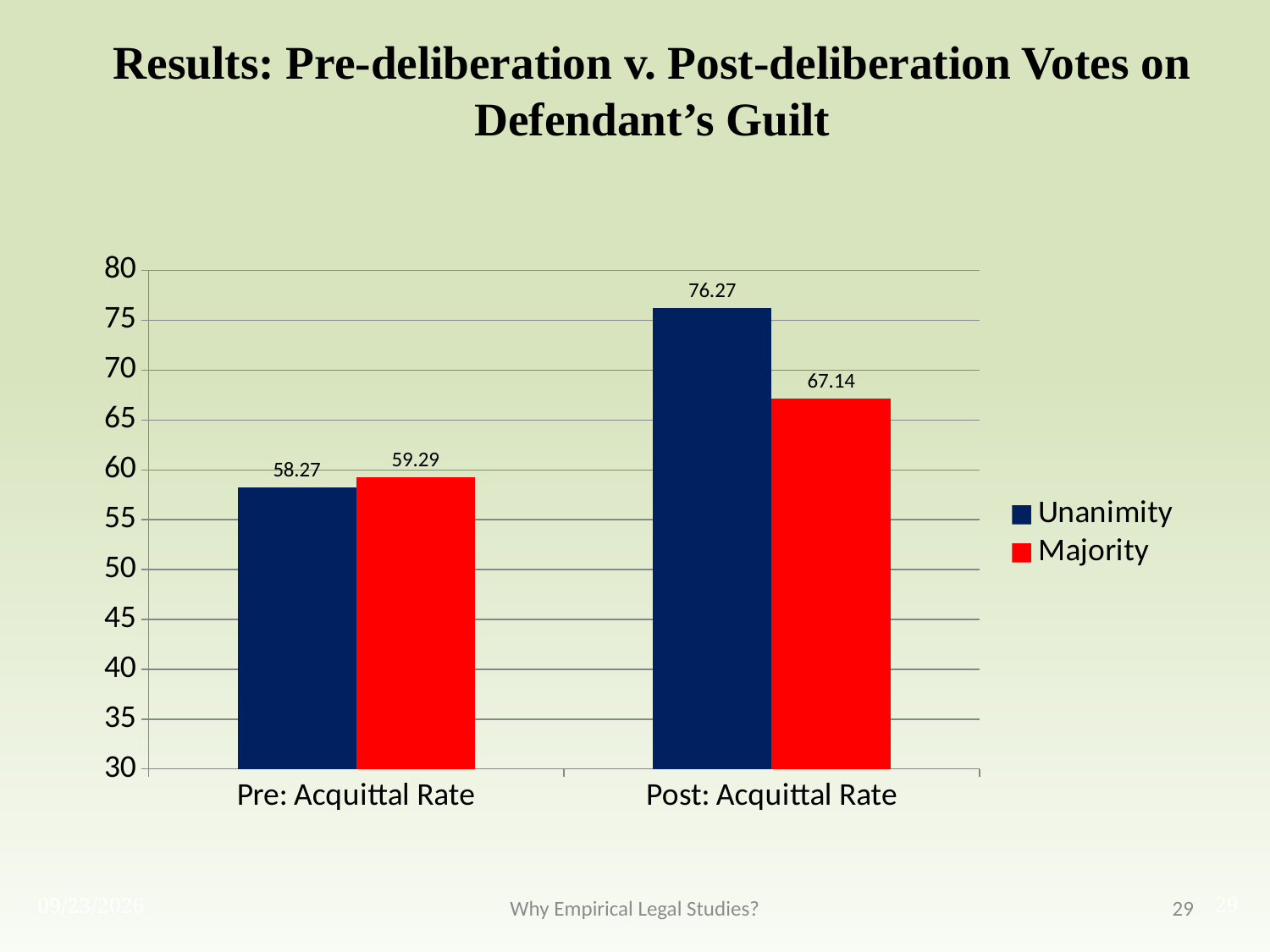
What is the difference between the Unanimity values for Post: Acquittal Rate and Pre: Acquittal Rate? 18 What is the difference between the Unanimity and Majority values for Post: Acquittal Rate? 9.13 What is the Majority value for Pre: Acquittal Rate? 59.29 Which bar has the highest value on the chart? Unanimity, Post: Acquittal Rate What is the Unanimity value for Post: Acquittal Rate? 76.27 How many categories are shown on the x axis? 2 Which bar has the lowest value on the chart? Unanimity, Pre: Acquittal Rate How many series does the legend list? 2 What kind of chart is shown on the slide? Bar chart For Post: Acquittal Rate, which series has the larger value, Unanimity or Majority? Unanimity What is the Majority value for Post: Acquittal Rate? 67.14 What is the Unanimity value for Pre: Acquittal Rate? 58.27